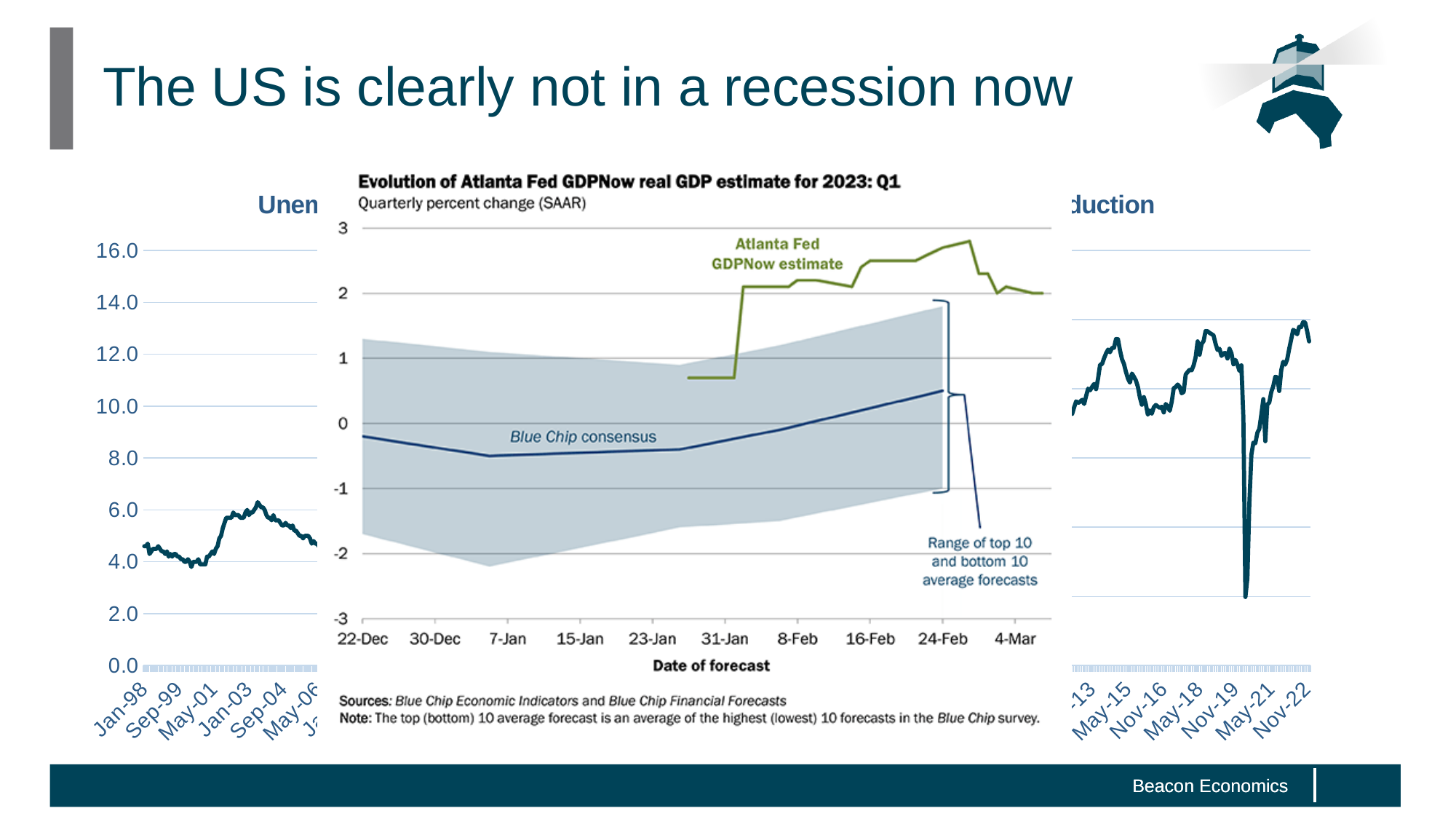
In the central GDPNow chart, is the Atlanta Fed GDPNow estimate at 4-Mar greater or less than 1? greater What does the shaded band in the central GDPNow chart represent? Range of top 10 and bottom 10 average forecasts In the central GDPNow chart, which is higher at 24-Feb: the Atlanta Fed GDPNow estimate or the Blue Chip consensus? Atlanta Fed GDPNow estimate In the central GDPNow chart, is the Blue Chip consensus at 24-Feb greater or less than 1? less In the central GDPNow chart, is the Atlanta Fed GDPNow estimate at 4-Mar greater or less than 3? less How many date labels are shown on the x axis of the central GDPNow chart? 10 In the central GDPNow chart, does the Atlanta Fed GDPNow estimate rise or fall between 24-Feb and 4-Mar? fall What kind of chart is the central chart titled 'Evolution of Atlanta Fed GDPNow real GDP estimate for 2023: Q1'? line chart In the central GDPNow chart, does the Blue Chip consensus rise or fall between 23-Jan and 24-Feb? rise What is the x-axis title of the central GDPNow chart? Date of forecast